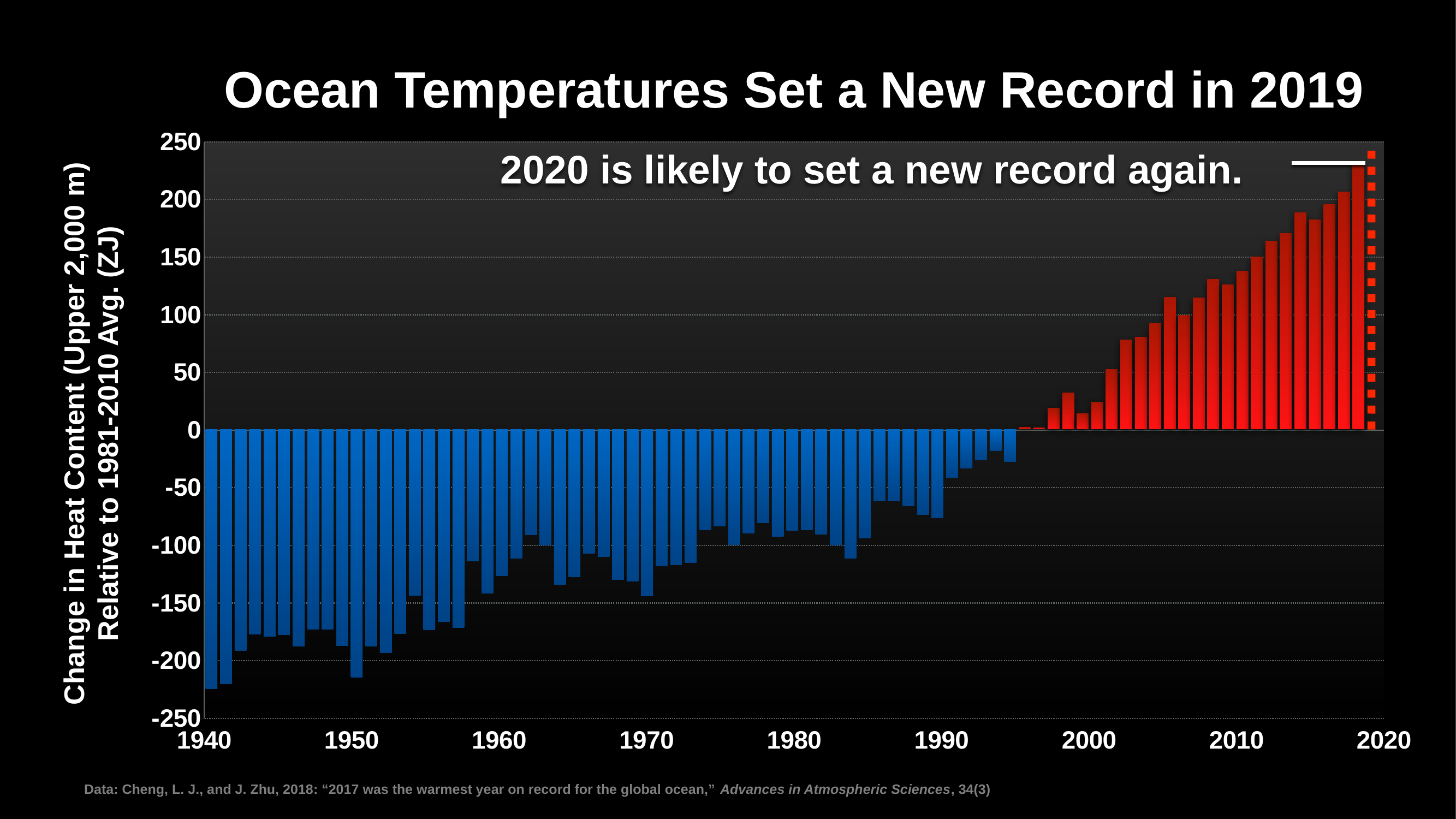
What kind of chart is shown on the slide? bar chart Is the value for 2010 greater or less than 100? greater What is the title of the chart? Ocean Temperatures Set a New Record in 2019 Overall, do the values rise or fall from 1940 to 2019? rise Is the value for 2000 greater or less than 50? less Is the value for 2019 greater or less than 200? greater What is the label of the vertical axis? Change in Heat Content (Upper 2,000 m) Relative to 1981-2010 Avg. (ZJ) Which year has the larger value, 1950 or 1960? 1960 Which year has the larger value, 2000 or 2010? 2010